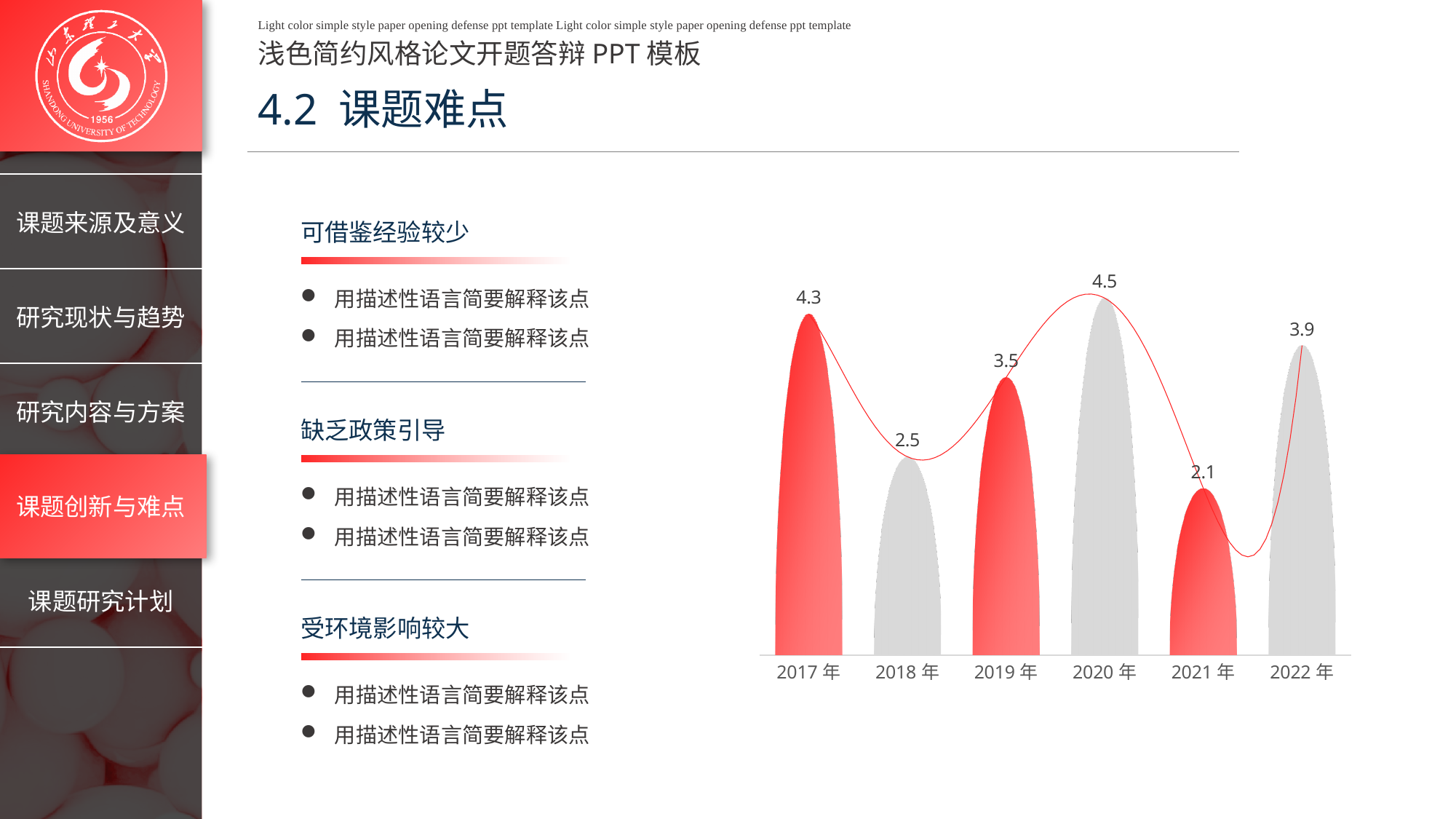
What is the value for 2017 年? 4.3 What colour are the bars for 2018 年, 2020 年 and 2022 年? grey What is the value for 2020 年? 4.5 Which year has the highest value? 2020 年 What is the difference between the values for 2017 年 and 2018 年? 1.8 Does the value rise or fall from 2021 年 to 2022 年? rise What is the difference between the values for 2020 年 and 2021 年? 2.4 Which is larger, the value for 2019 年 or the value for 2022 年? 2022 年 Which year has the lowest value? 2021 年 What is the value for 2022 年? 3.9 How many years are shown on the x axis of the chart? 6 What is the value for 2021 年? 2.1